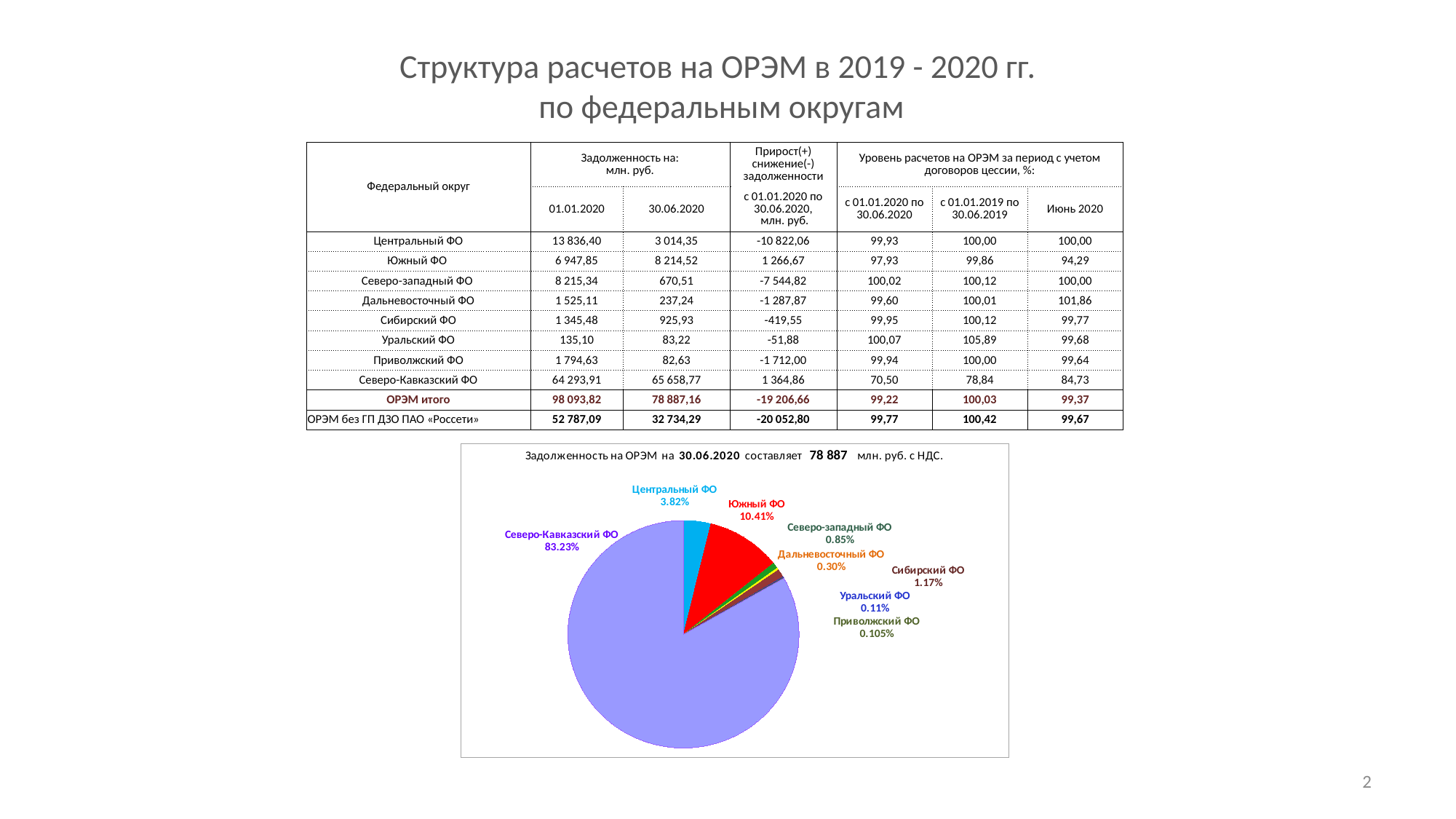
What kind of chart is shown on the slide? Pie chart Which has a larger share in the pie chart, Южный ФО or Центральный ФО? Южный ФО By how many percentage points does the share of Северо-Кавказский ФО exceed that of Южный ФО in the pie chart? 72.82 Which federal district has the largest slice in the pie chart? Северо-Кавказский ФО What percentage is shown for Центральный ФО in the pie chart? 3.82% What share of the pie chart does Северо-Кавказский ФО account for? 83.23% According to the pie chart's title, what is the total debt on ОРЭМ as of 30.06.2020? 78 887 млн. руб. с НДС What percentage is shown for Дальневосточный ФО in the pie chart? 0.30% How many slices does the pie chart have? 8 What percentage is shown for Сибирский ФО in the pie chart? 1.17% What percentage is shown for Южный ФО in the pie chart? 10.41% Which federal district has the smallest share in the pie chart? Приволжский ФО